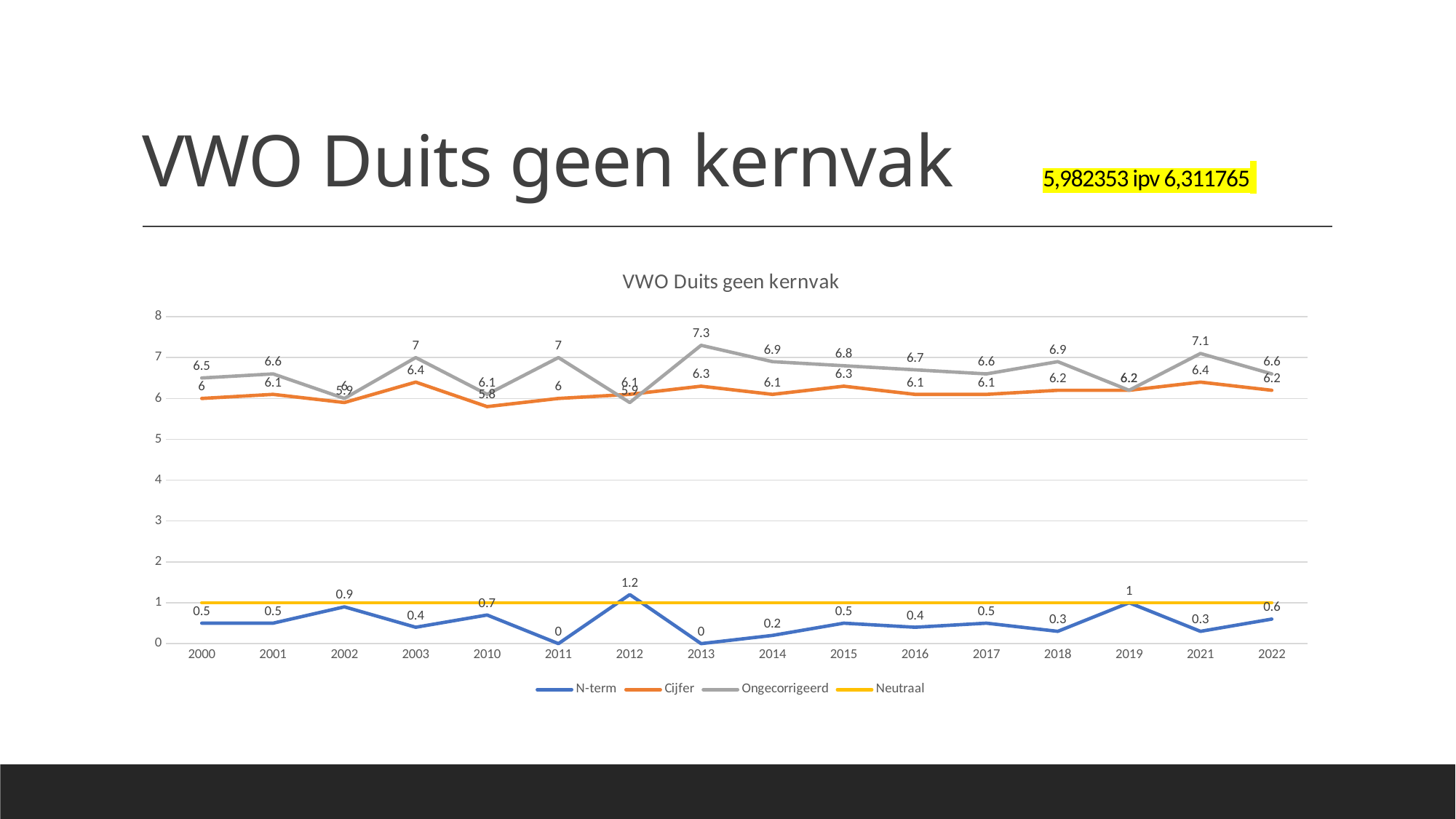
What is the Cijfer value for 2010? 5.8 In which year is the Ongecorrigeerd value highest? 2013 What type of chart is shown on the slide? line chart In which year is the N-term highest? 2012 How many years are plotted along the x axis? 16 Which is larger in 2021, the Ongecorrigeerd value or the Cijfer value? Ongecorrigeerd What is the Ongecorrigeerd value for 2013? 7.3 Is the Neutraal line greater or less than 2? less How many series does the legend list? 4 What is the N-term value for 2012? 1.2 What is the title of the chart? VWO Duits geen kernvak What is the difference between the Ongecorrigeerd value and the Cijfer value in 2013? 1